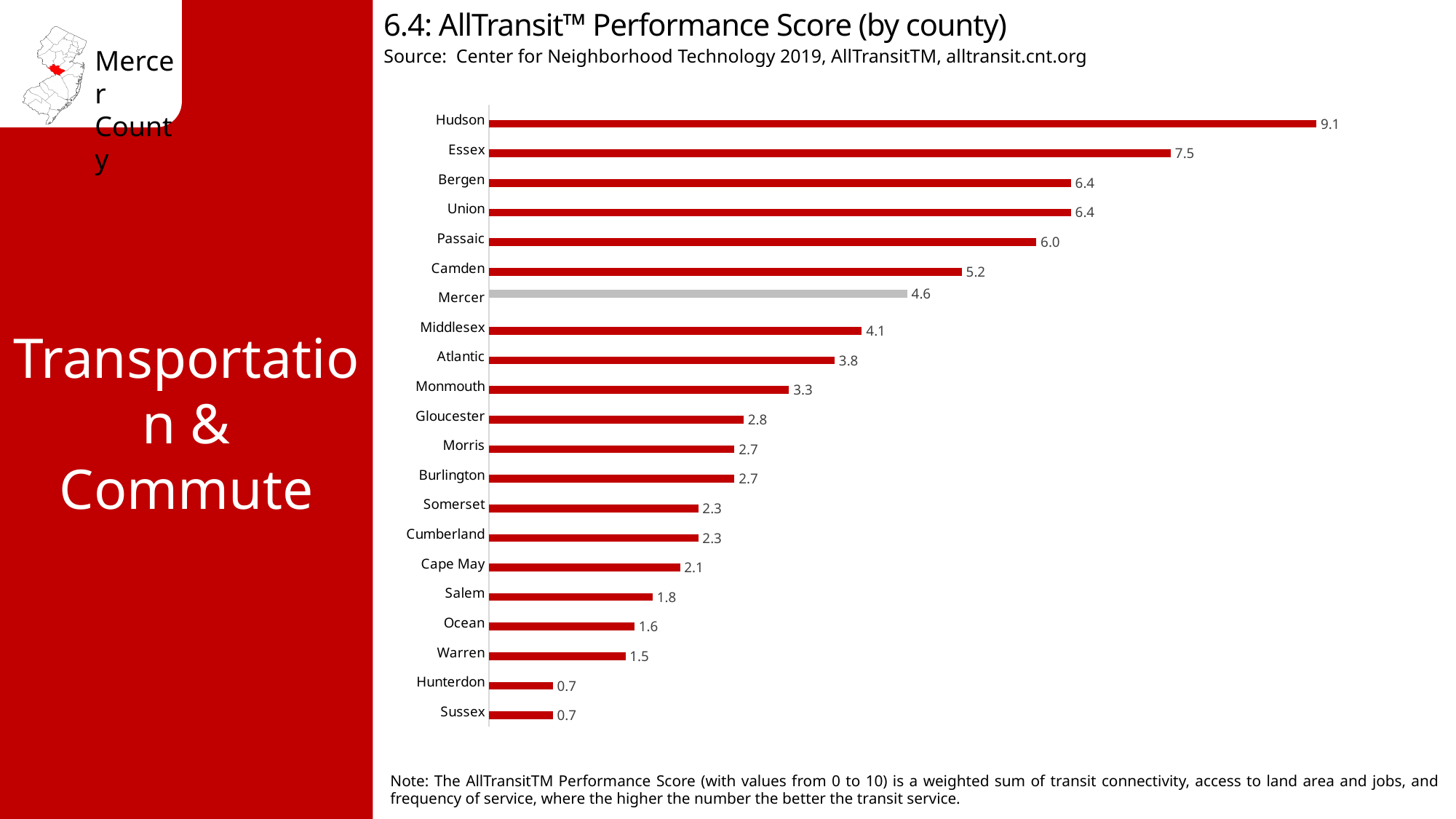
Which county has a higher AllTransit Performance Score, Monmouth or Atlantic? Atlantic Which county has the highest AllTransit Performance Score? Hudson What is the AllTransit Performance Score for Sussex County? 0.7 Which county has a higher AllTransit Performance Score, Passaic or Camden? Passaic What is the difference between the AllTransit Performance Scores of Mercer and Middlesex? 0.5 What is the AllTransit Performance Score for Camden County? 5.2 How many counties are shown in the chart? 21 What is the AllTransit Performance Score for Mercer County? 4.6 What is the AllTransit Performance Score for Hudson County? 9.1 Which county's bar is shown in gray rather than red? Mercer What is the difference between the AllTransit Performance Scores of Hudson and Essex? 1.6 What type of chart is used to show the AllTransit Performance Score by county? Bar chart